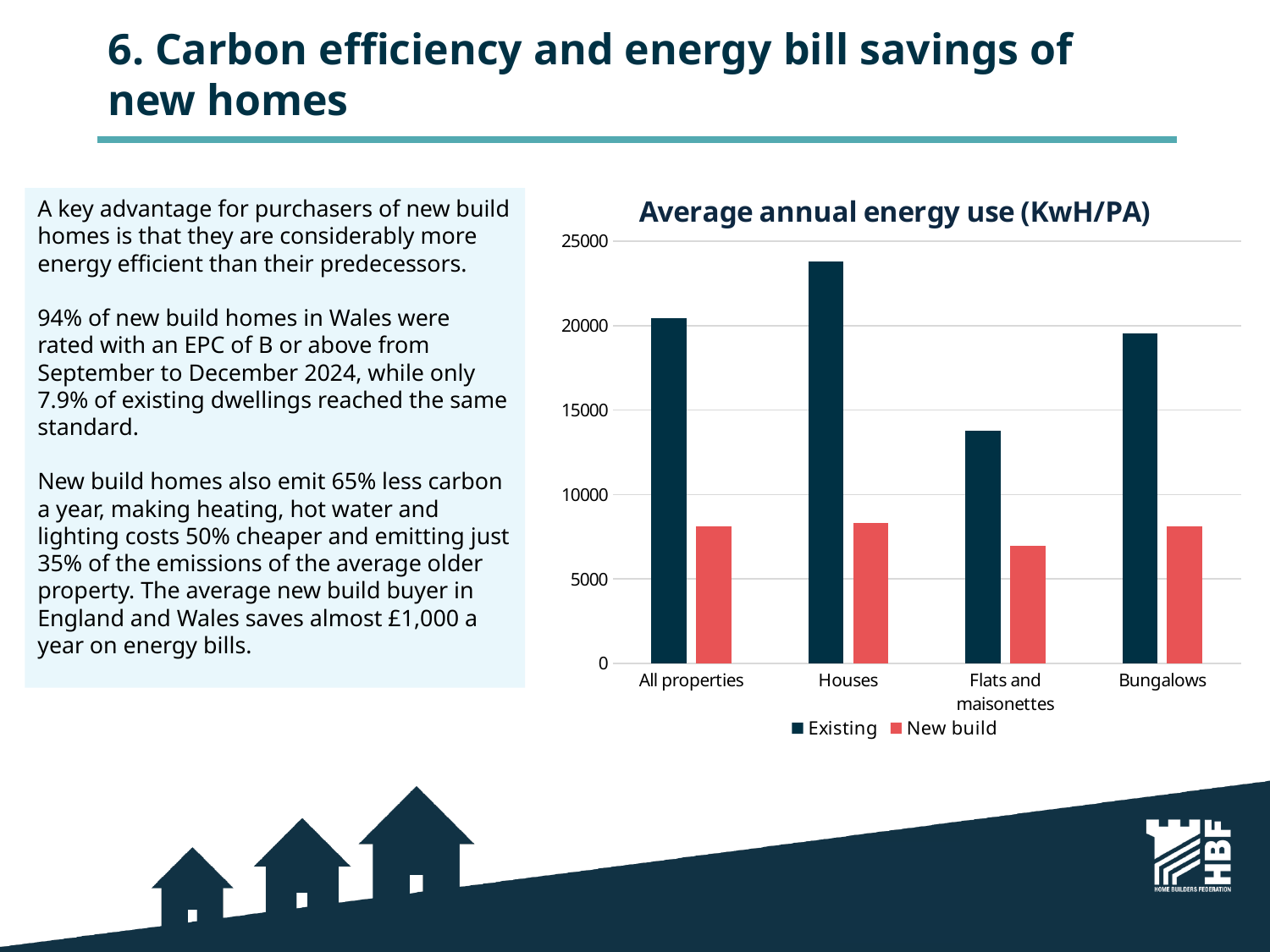
Which is larger: the Existing value for Houses or the Existing value for Bungalows? Houses Is the Existing value for Houses greater or less than 20000? greater Is the New build value for All properties greater or less than 10000? less How many series does the chart legend list? 2 What kind of chart is shown on the slide? bar chart Is the Existing value for Flats and maisonettes greater or less than 15000? less Which category has the highest Existing value? Houses How many property categories are shown on the x axis? 4 Which series is shown in red in the chart? New build What is the title of the chart? Average annual energy use (KwH/PA) Which category has the lowest Existing value? Flats and maisonettes Which category has the lowest New build value? Flats and maisonettes